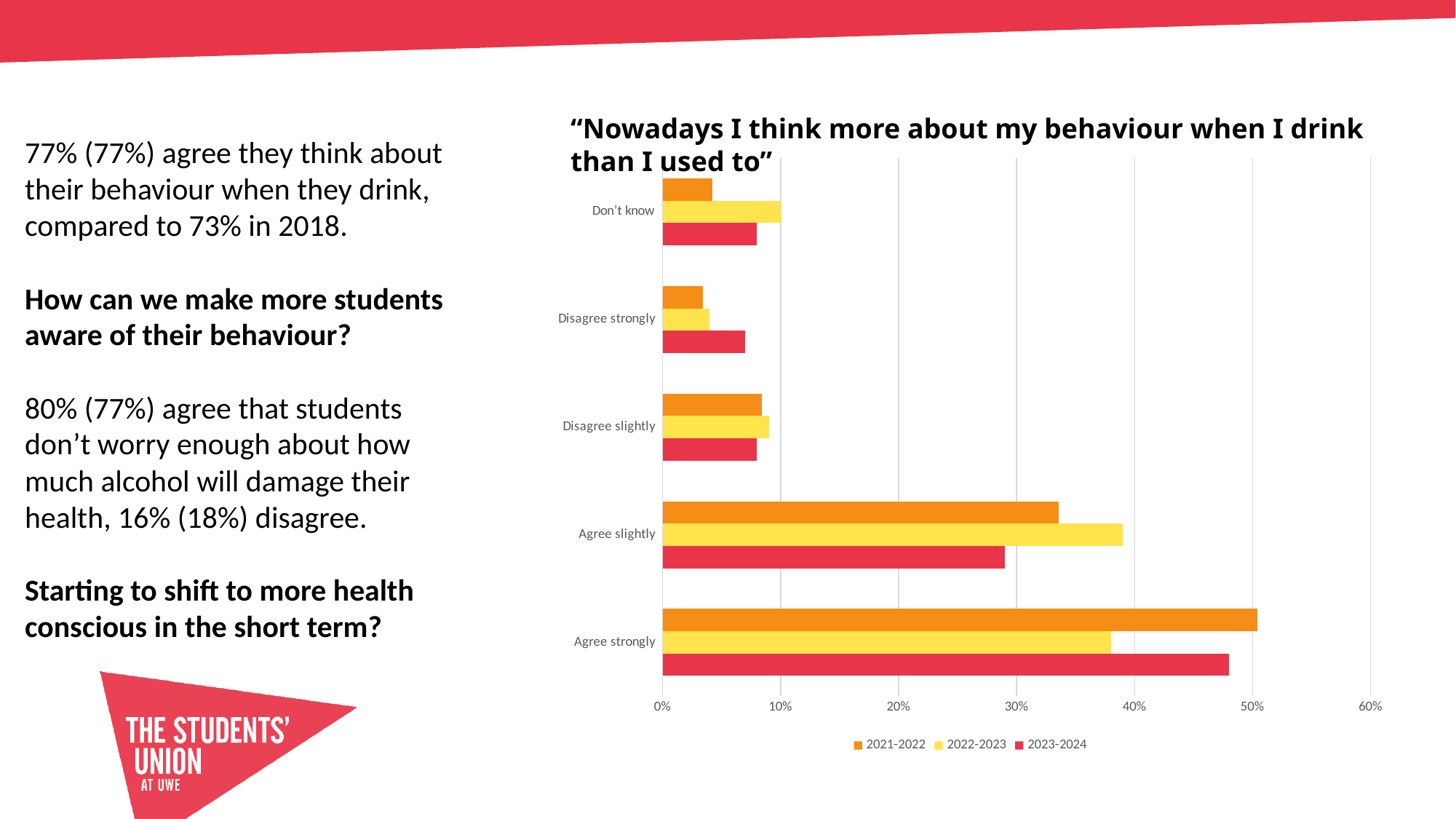
How many response categories are shown on the chart? 5 Which series is shown in yellow in the chart's legend? 2022-2023 What kind of chart is shown on the slide? Bar chart Is the value for Agree strongly in 2022-2023 greater or less than 40%? less Is the value for Agree strongly in 2021-2022 greater or less than 40%? greater For Agree slightly, which series has the larger value: 2022-2023 or 2023-2024? 2022-2023 Is the value for Disagree strongly in 2023-2024 greater or less than 10%? less Which category has the highest value for the 2023-2024 series? Agree strongly Which category has the highest value for the 2021-2022 series? Agree strongly For Agree strongly, which series has the larger value: 2021-2022 or 2022-2023? 2021-2022 How many series does the chart's legend list? 3